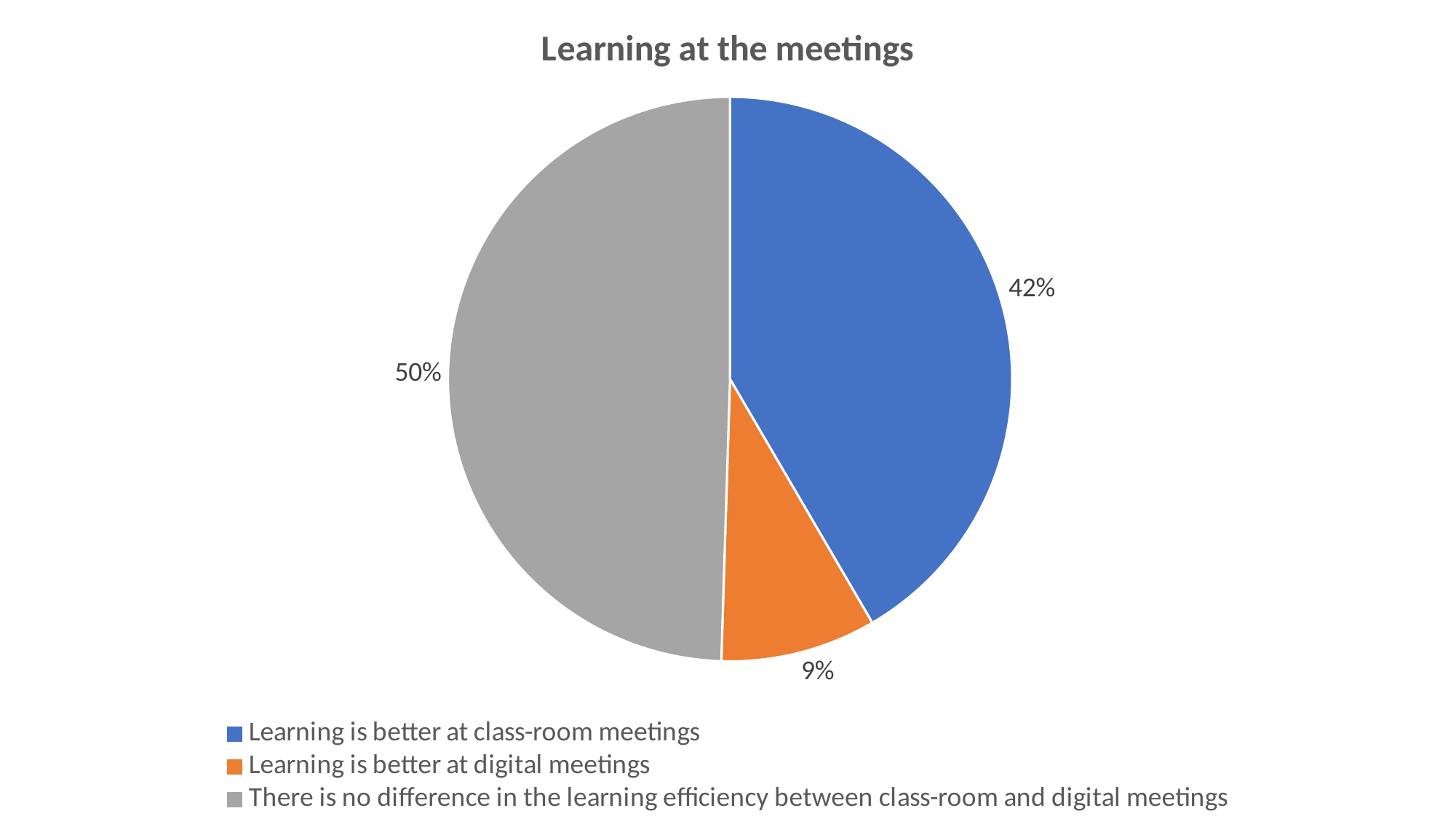
What share of the pie is labelled for 'Learning is better at class-room meetings'? 42% Which category has the largest slice of the pie? There is no difference in the learning efficiency between class-room and digital meetings Which is larger: the slice for 'Learning is better at class-room meetings' or the slice for 'Learning is better at digital meetings'? Learning is better at class-room meetings What share of the pie is labelled for 'Learning is better at digital meetings'? 9% What share of the pie is labelled for 'There is no difference in the learning efficiency between class-room and digital meetings'? 50% What kind of chart is shown on the slide? Pie chart What is the difference in percentage points between the 'no difference' slice and the class-room meetings slice? 8 What is the difference in percentage points between the class-room meetings slice and the digital meetings slice? 33 How many categories does the pie chart show? 3 Which category has the smallest slice of the pie? Learning is better at digital meetings Which colour represents 'Learning is better at digital meetings' in the legend? Orange What is the title of the chart? Learning at the meetings